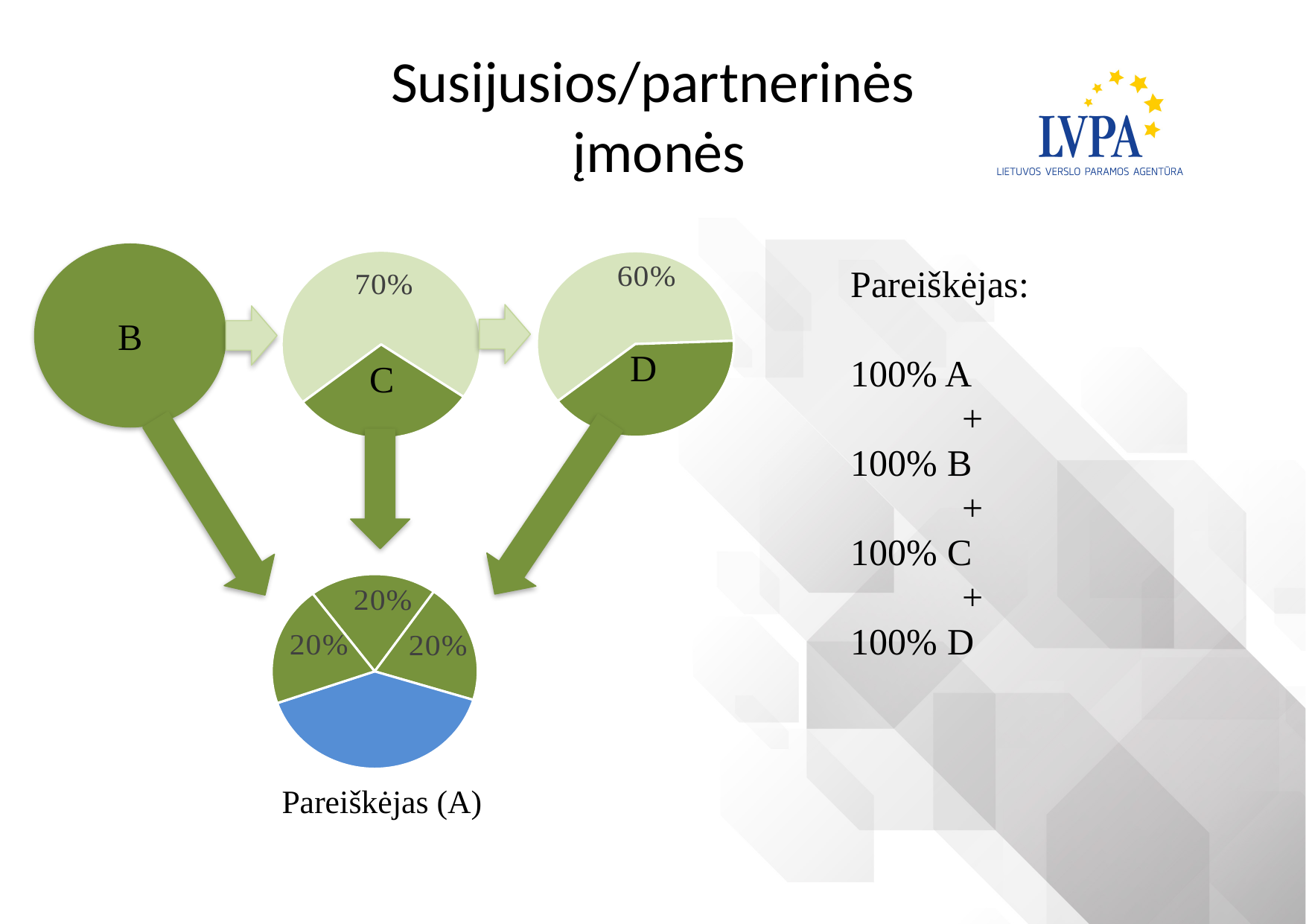
What is the combined share of the three slices labelled 20% in the Pareiškėjas (A) pie chart? 60% In the Pareiškėjas (A) pie chart, what percentage is printed on each of the green slices? 20% What kind of chart is used for the Pareiškėjas (A) diagram at the bottom of the slide? pie chart In the pie chart labelled D, what percentage is printed on the light green slice? 60% How many slices does the Pareiškėjas (A) pie chart have? 4 What is the difference between the labelled slice in the C pie chart (70%) and the labelled slice in the D pie chart (60%)? 10% In the pie chart labelled C, what percentage is printed on the light green slice? 70% What label appears below the bottom pie chart? Pareiškėjas (A) How many slices in the Pareiškėjas (A) pie chart are labelled 20%? 3 How many slices does the pie chart labelled C have? 2 Which is larger: the labelled light green slice in the C pie chart or the labelled light green slice in the D pie chart? C pie chart (70%) What colour is the unlabelled slice in the Pareiškėjas (A) pie chart? blue